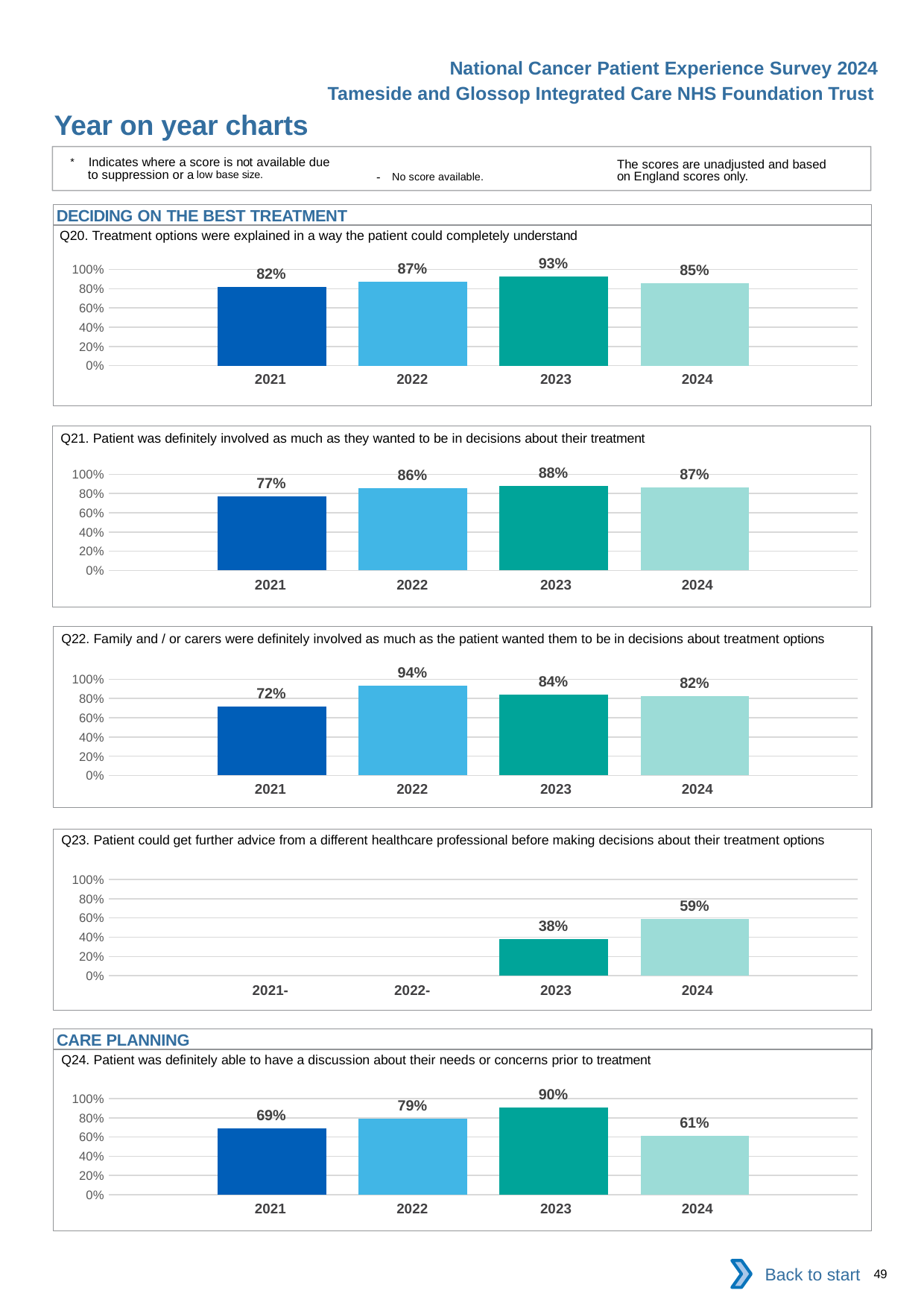
How many charts are shown on the slide? 5 In the Q21 chart, do the values rise or fall from 2021 to 2023? Rise In the Q24 chart, which is larger, the value for 2022 or the value for 2024? 2022 In the Q22 chart, is the value for 2021 greater or less than 80%? less In the Q20 chart, what is the value for 2023? 93% In the Q23 chart, what is the difference between the 2024 and 2023 values? 21 percentage points In the Q21 chart, which year has the lowest value? 2021 In the Q22 chart, which year has the highest value? 2022 In the Q24 chart, what is the value for 2024? 61% What kind of chart is the Q20 chart? Bar chart In the Q20 chart, what is the difference between the 2023 and 2021 values? 11 percentage points In the Q23 chart, how many years have a bar plotted? 2